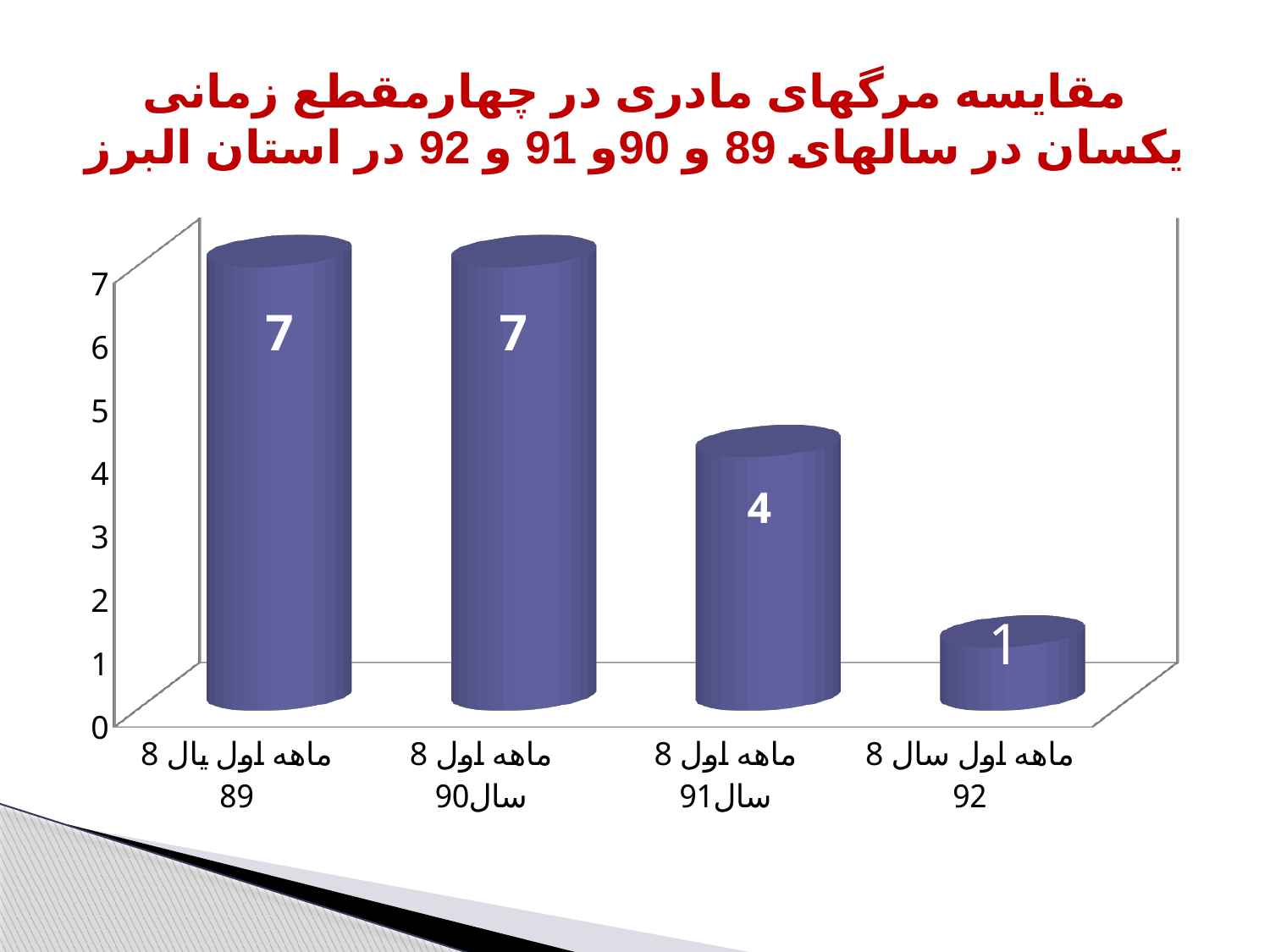
What is the value for the first 8 months of year 91 (8 ماهه اول سال 91)? 4 What is the difference between the value for year 91 and the value for year 92? 3 What is the value for the first 8 months of year 92 (8 ماهه اول سال 92)? 1 What is the value for the first 8 months of year 90 (8 ماهه اول سال 90)? 7 Do the values rise or fall from year 89 to year 92 along the x axis? fall Which category has the lowest value? 8 ماهه اول سال 92 How many categories are shown on the x axis? 4 Which categories share the highest value? 8 ماهه اول سال 89 and 8 ماهه اول سال 90 What is the value for the first 8 months of year 89 (8 ماهه اول سال 89)? 7 What is the difference between the value for year 90 and the value for year 91? 3 Which is larger, the value for year 91 or the value for year 92? year 91 What kind of chart is shown on the slide? bar chart